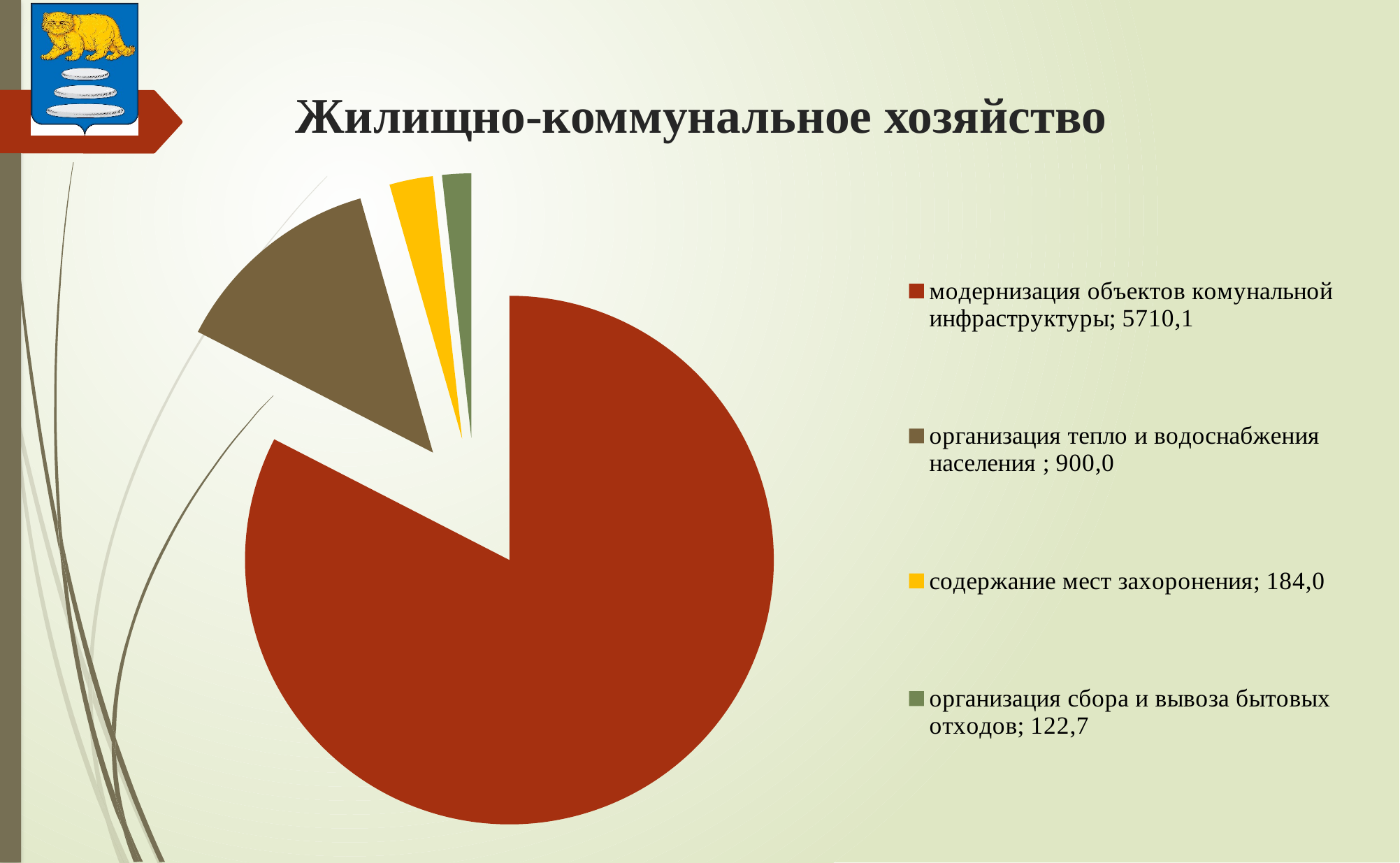
What is the value for "модернизация объектов комунальной инфраструктуры"? 5710,1 What is the difference between the values for "содержание мест захоронения" and "организация сбора и вывоза бытовых отходов"? 61,3 What is the value for "содержание мест захоронения"? 184,0 How many categories does the pie chart have? 4 Which is larger: the value for "организация тепло и водоснабжения населения" or for "содержание мест захоронения"? организация тепло и водоснабжения населения What kind of chart is shown on the slide? pie chart What is the value for "организация сбора и вывоза бытовых отходов"? 122,7 What is the value for "организация тепло и водоснабжения населения"? 900,0 Which category has the smallest slice of the pie? организация сбора и вывоза бытовых отходов What is the difference between the values for "модернизация объектов комунальной инфраструктуры" and "организация тепло и водоснабжения населения"? 4810,1 What is the title of the slide containing the pie chart? Жилищно-коммунальное хозяйство Which category has the largest slice of the pie? модернизация объектов комунальной инфраструктуры